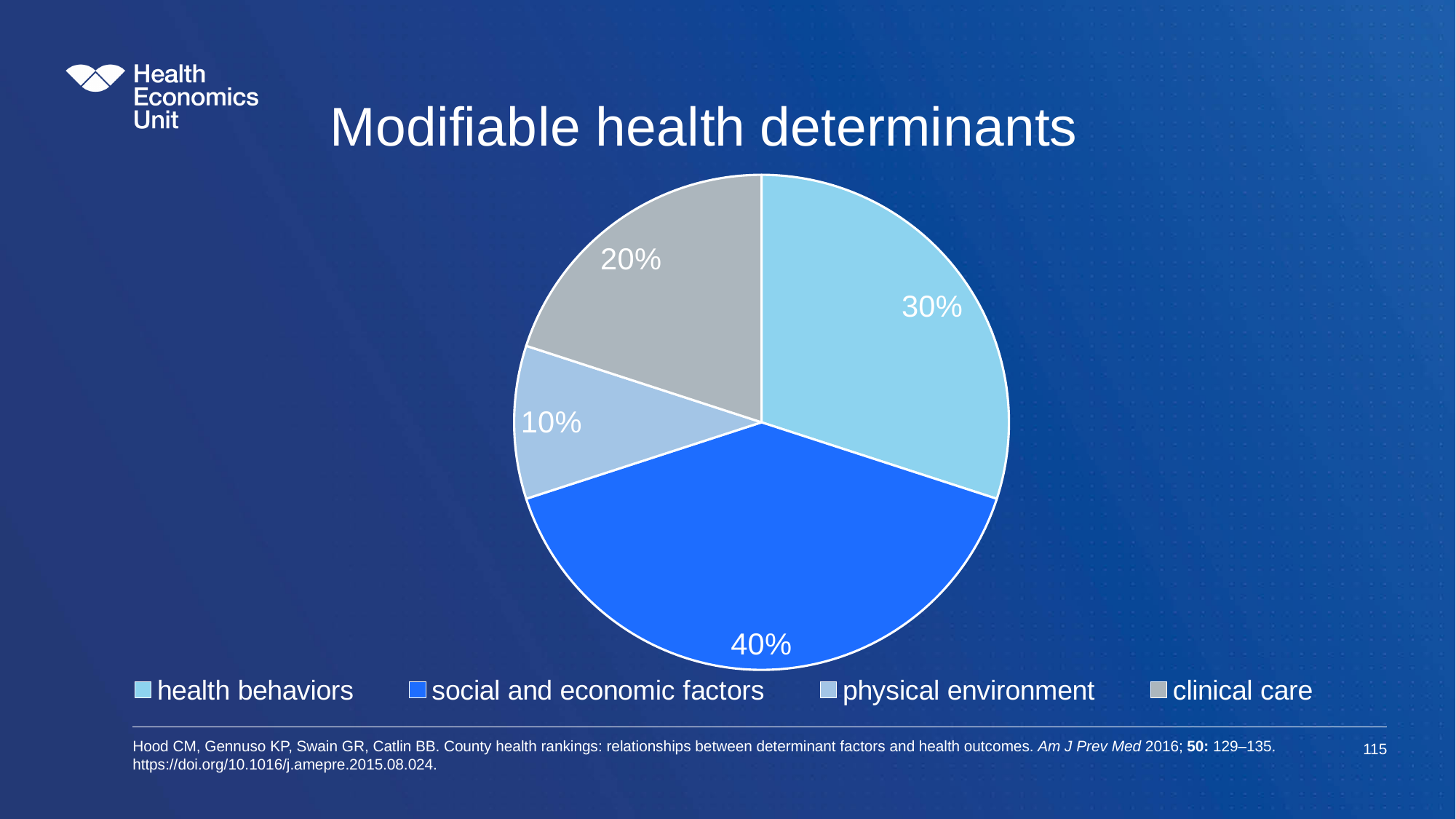
Which legend entry is shown in grey? clinical care Which category has the largest slice of the pie? social and economic factors What share of the pie is health behaviors? 30% What is the difference in percentage points between social and economic factors and clinical care? 20 Which category has the smallest slice of the pie? physical environment What share of the pie is clinical care? 20% What share of the pie is physical environment? 10% How many categories does the pie chart have? 4 What share of the pie is social and economic factors? 40% What is the title of the chart? Modifiable health determinants What kind of chart is shown on the slide? pie chart Which is larger, health behaviors or clinical care? health behaviors